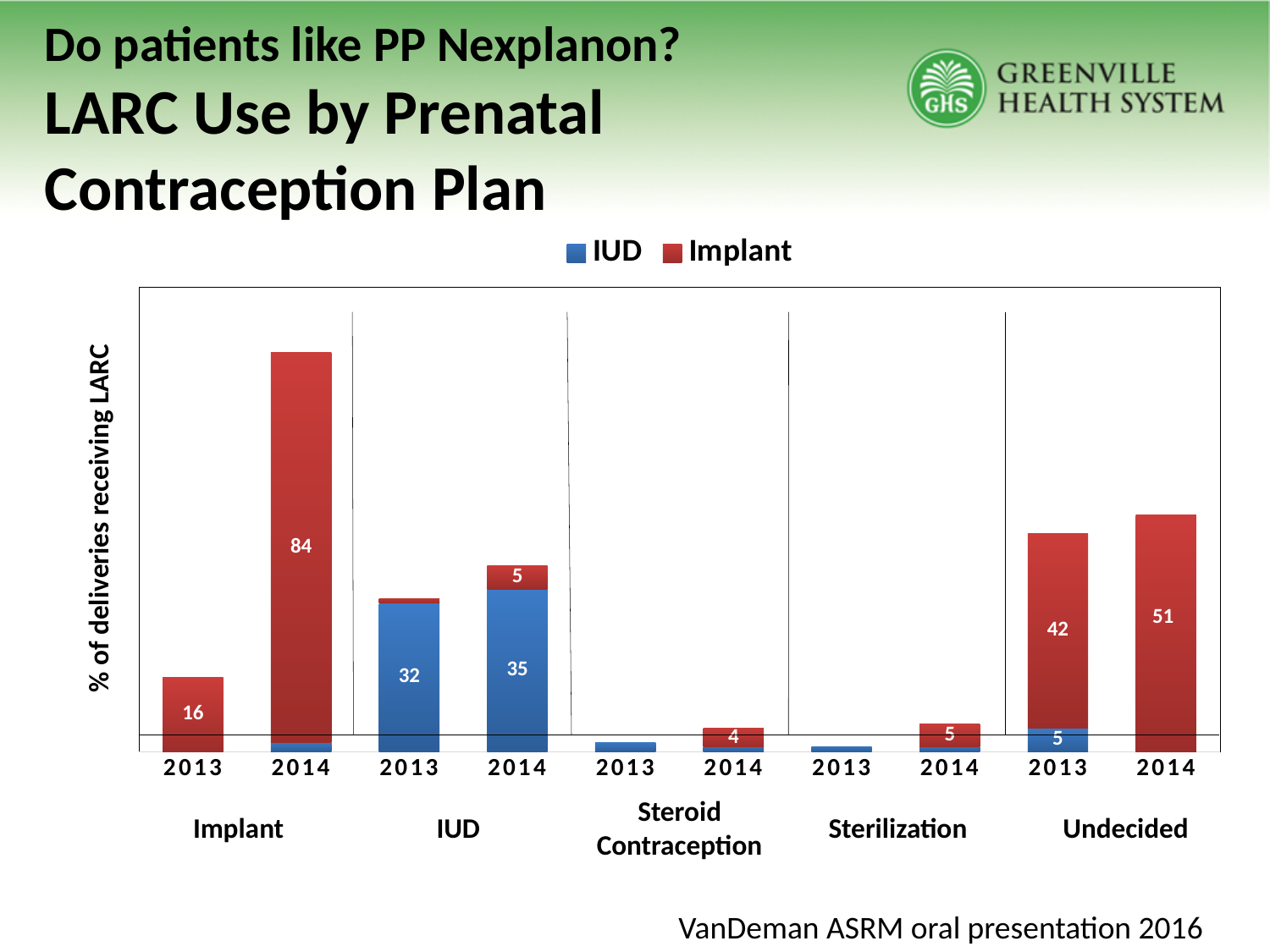
What is the total of the stacked bar for the IUD plan group in 2014? 40 Which bar is the tallest in the chart? Implant 2014 What is the Implant value for the Steroid Contraception plan group in 2014? 4 What is the IUD value for the IUD plan group in 2013? 32 How many series does the legend list? 2 What kind of chart is shown on the slide? Stacked bar chart What is the Implant value for the Implant plan group in 2014? 84 How many prenatal contraception plan groups are shown on the x axis? 5 What is the total of the stacked bar for the Undecided plan group in 2013? 47 What is the Implant value for the Implant plan group in 2013? 16 What is the difference between the Implant values for the Implant plan group in 2014 and 2013? 68 What is the Implant value for the Undecided plan group in 2014? 51